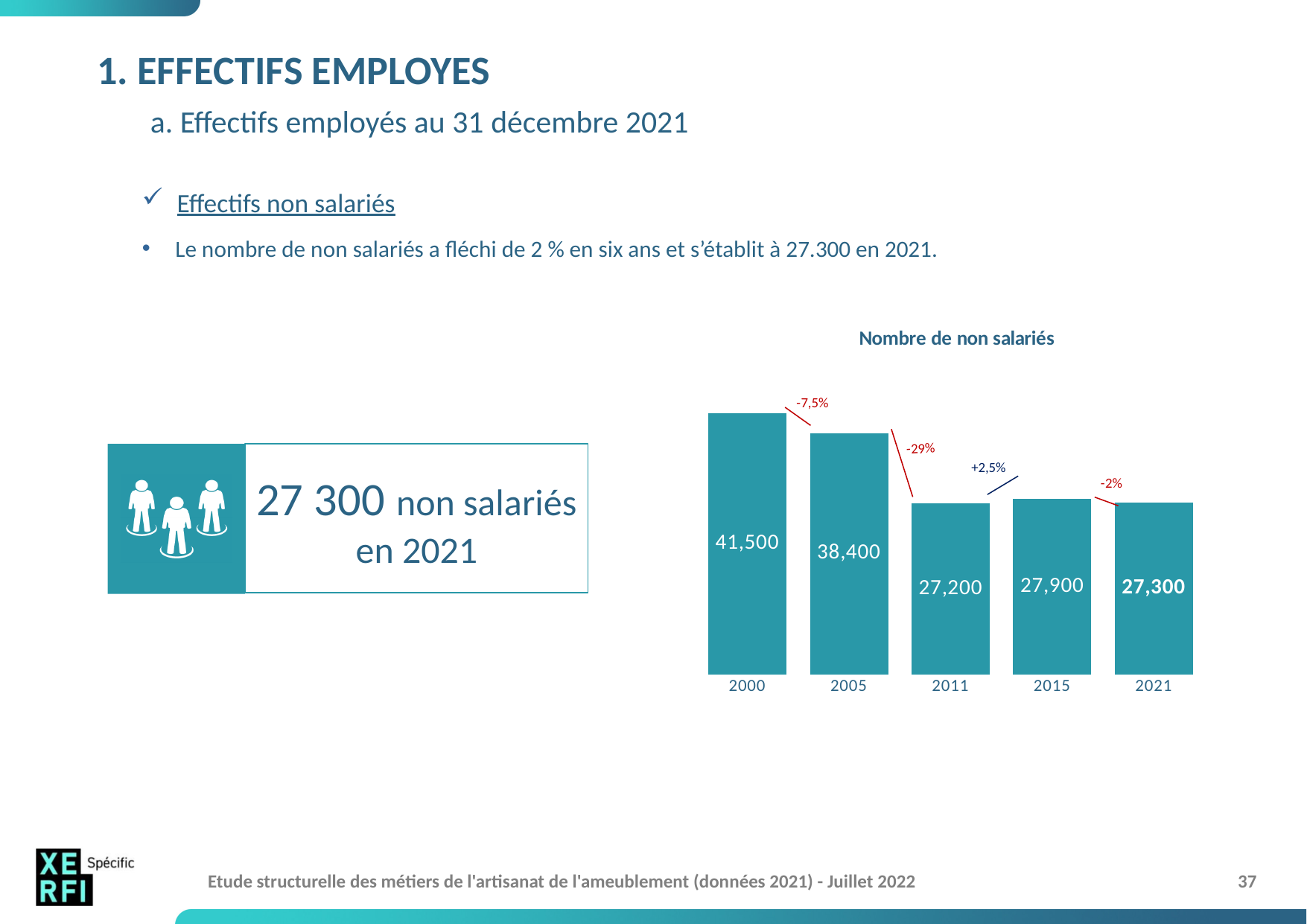
How many years are shown in the 'Nombre de non salariés' chart? 5 What kind of chart is the 'Nombre de non salariés' chart? bar chart What is the difference between the values for 2015 and 2021 in the 'Nombre de non salariés' chart? 600 Which year has the highest value in the 'Nombre de non salariés' chart? 2000 What is the difference between the values for 2000 and 2005 in the 'Nombre de non salariés' chart? 3,100 What percentage change is shown between 2005 and 2011 in the 'Nombre de non salariés' chart? -29% What is the value for 2000 in the 'Nombre de non salariés' chart? 41,500 What is the value for 2021 in the 'Nombre de non salariés' chart? 27,300 What is the title of the chart on the slide? Nombre de non salariés Which is larger in the 'Nombre de non salariés' chart, the value for 2005 or the value for 2015? 2005 Which year has the lowest value in the 'Nombre de non salariés' chart? 2011 What is the value for 2011 in the 'Nombre de non salariés' chart? 27,200